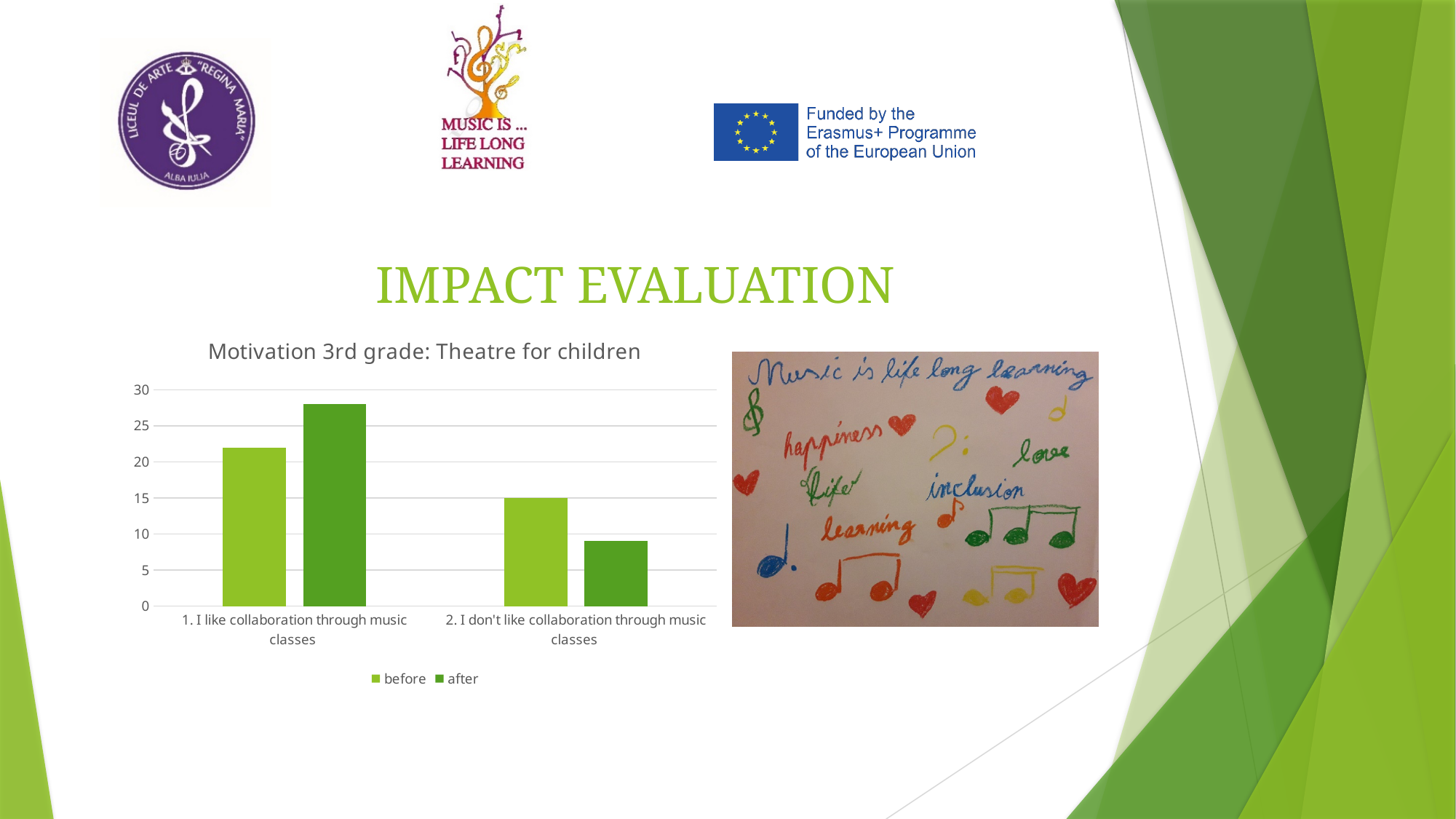
Which bar in the chart is the tallest? after, for '1. I like collaboration through music classes' What is the title of the chart on the slide? Motivation 3rd grade: Theatre for children What kind of chart is shown on the slide? bar chart Is the 'after' value for '2. I don't like collaboration through music classes' greater or less than 10? less How many series does the chart legend list? 2 What are the two series named in the chart legend? before and after Is the 'before' value for '2. I don't like collaboration through music classes' greater or less than 20? less For '1. I like collaboration through music classes', which is larger: the 'before' value or the 'after' value? after Is the 'before' value for '1. I like collaboration through music classes' greater or less than 25? less For '2. I don't like collaboration through music classes', which is larger: the 'before' value or the 'after' value? before How many categories are shown on the x axis of the chart? 2